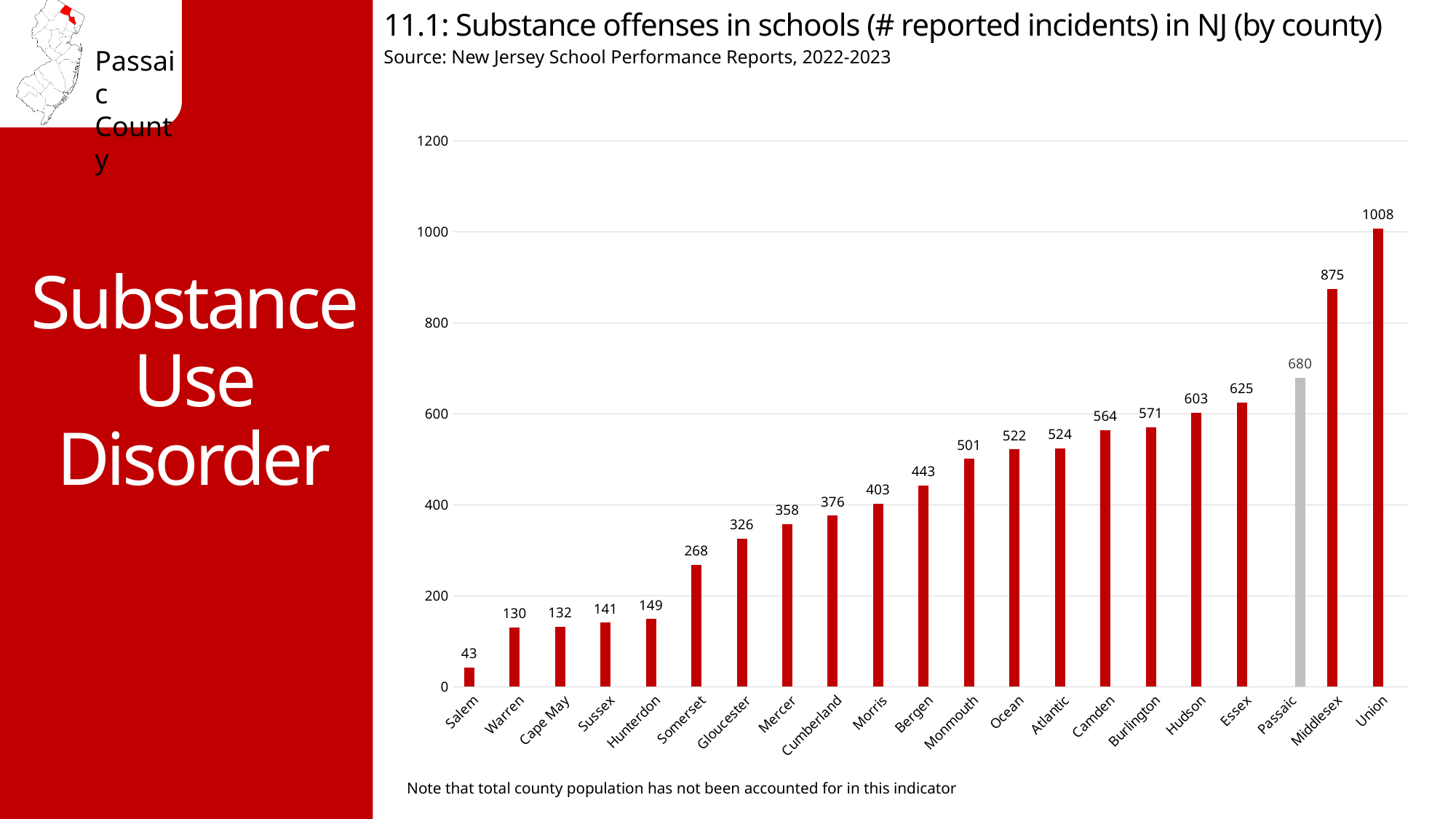
Which bar is coloured grey instead of red? Passaic What is the value shown for Middlesex county? 875 Which county has the highest number of reported incidents? Union What is the difference between the values for Union and Passaic? 328 Is the value for Bergen greater or less than 400? greater What is the value shown for Somerset county? 268 What kind of chart is shown on the slide? bar chart What is the number of reported substance offense incidents in schools for Passaic county? 680 Which county has the lowest number of reported incidents? Salem Do the values rise or fall moving from left to right along the x axis? rise Which county has a higher value, Essex or Hudson? Essex How many counties are shown on the chart? 21